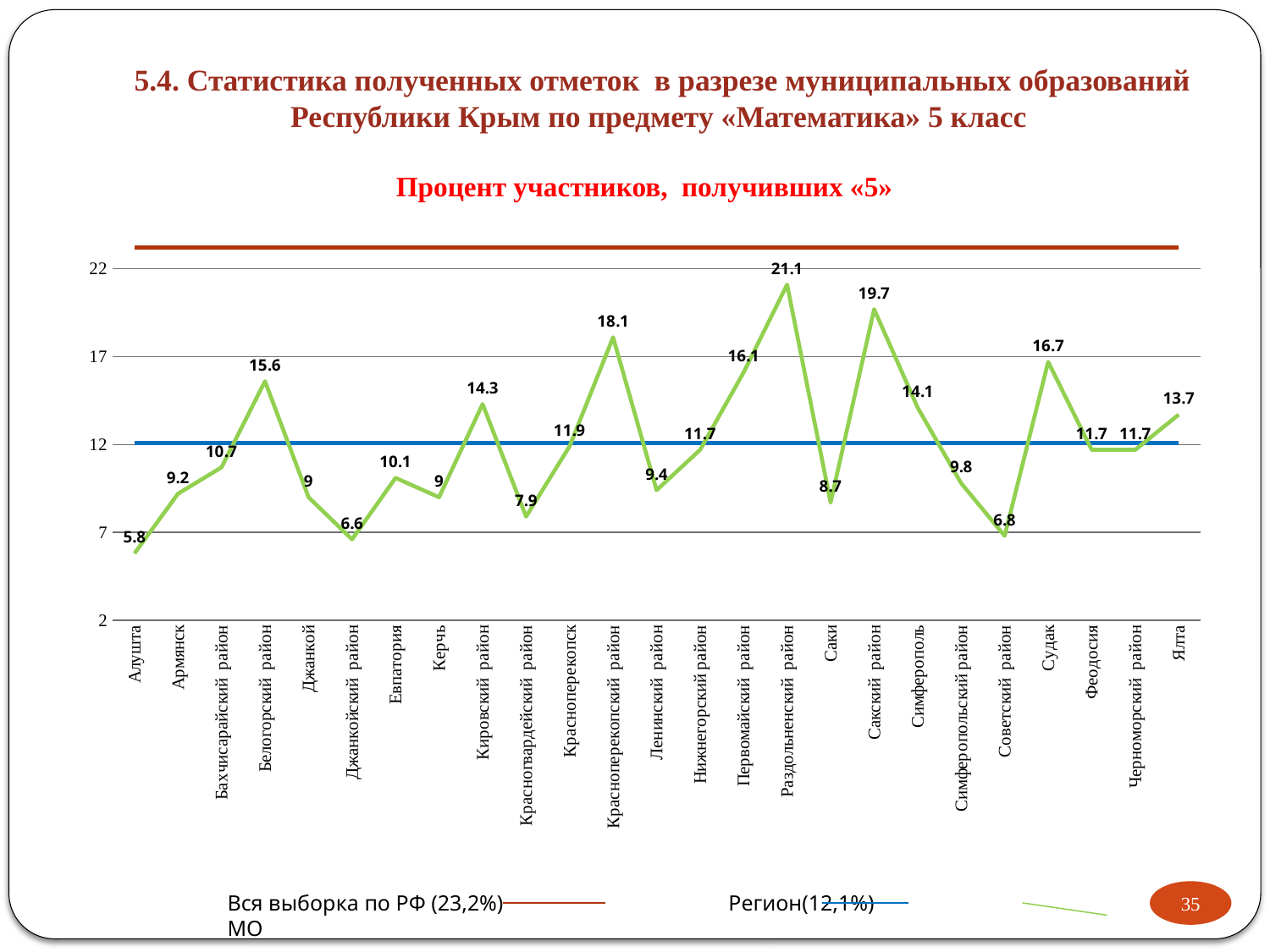
Which is larger, the value for Кировский район or the value for Симферополь? Кировский район What is the value for Раздольненский район? 21.1 What kind of chart is shown on the slide? line chart What is the difference between the values for Судак and Феодосия? 5 Which municipality has the lowest percentage of participants who received a «5»? Алушта How many series does the legend list? 3 Is the value for Красноперекопский район greater or less than 17? greater What is the value for Ялта? 13.7 How many municipalities are plotted on the x axis? 25 What is the difference between the values for Сакский район and Саки? 11 Which municipality has the highest percentage of participants who received a «5»? Раздольненский район What is the value for Белогорский район? 15.6